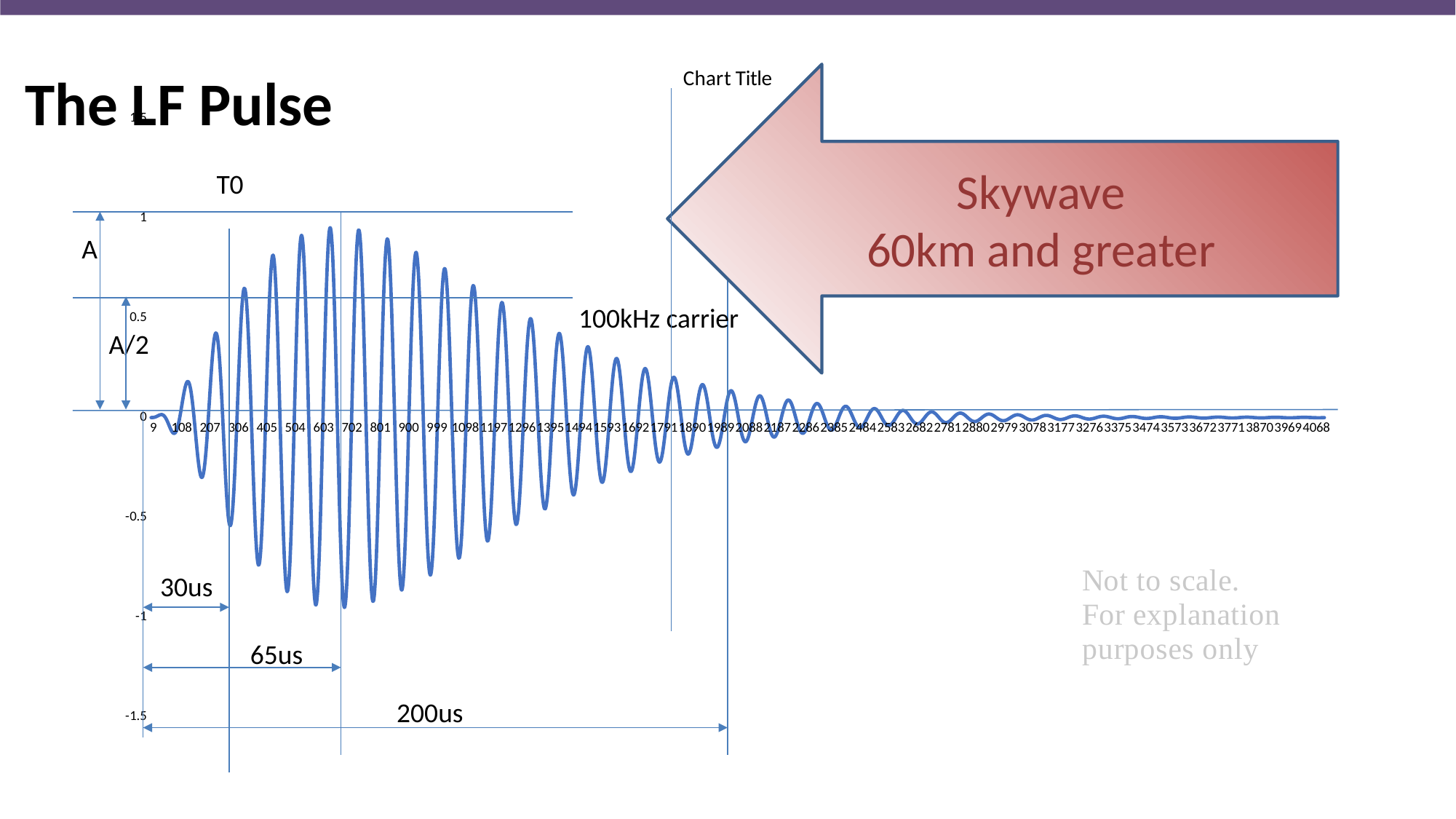
What is the last label on the chart's horizontal axis? 4068 Is the oscillation amplitude larger near the x-axis label 702 or near the x-axis label 3078? 702 What is the lowest tick value shown on the chart's vertical axis? -1.5 Is the value of the waveform near the x-axis label 4068 greater or less than 0.5? less What is the highest tick value shown on the chart's vertical axis? 1.5 What is the title shown above the chart? Chart Title What colour is the plotted waveform line? blue What kind of chart is shown on the slide? line chart Is the lowest trough of the waveform greater or less than -0.5? less Is the highest peak of the waveform greater or less than 0.5? greater After the peak near the x-axis label 702, does the amplitude of the oscillations increase or decrease along the x axis? decrease What is the first label on the chart's horizontal axis? 9